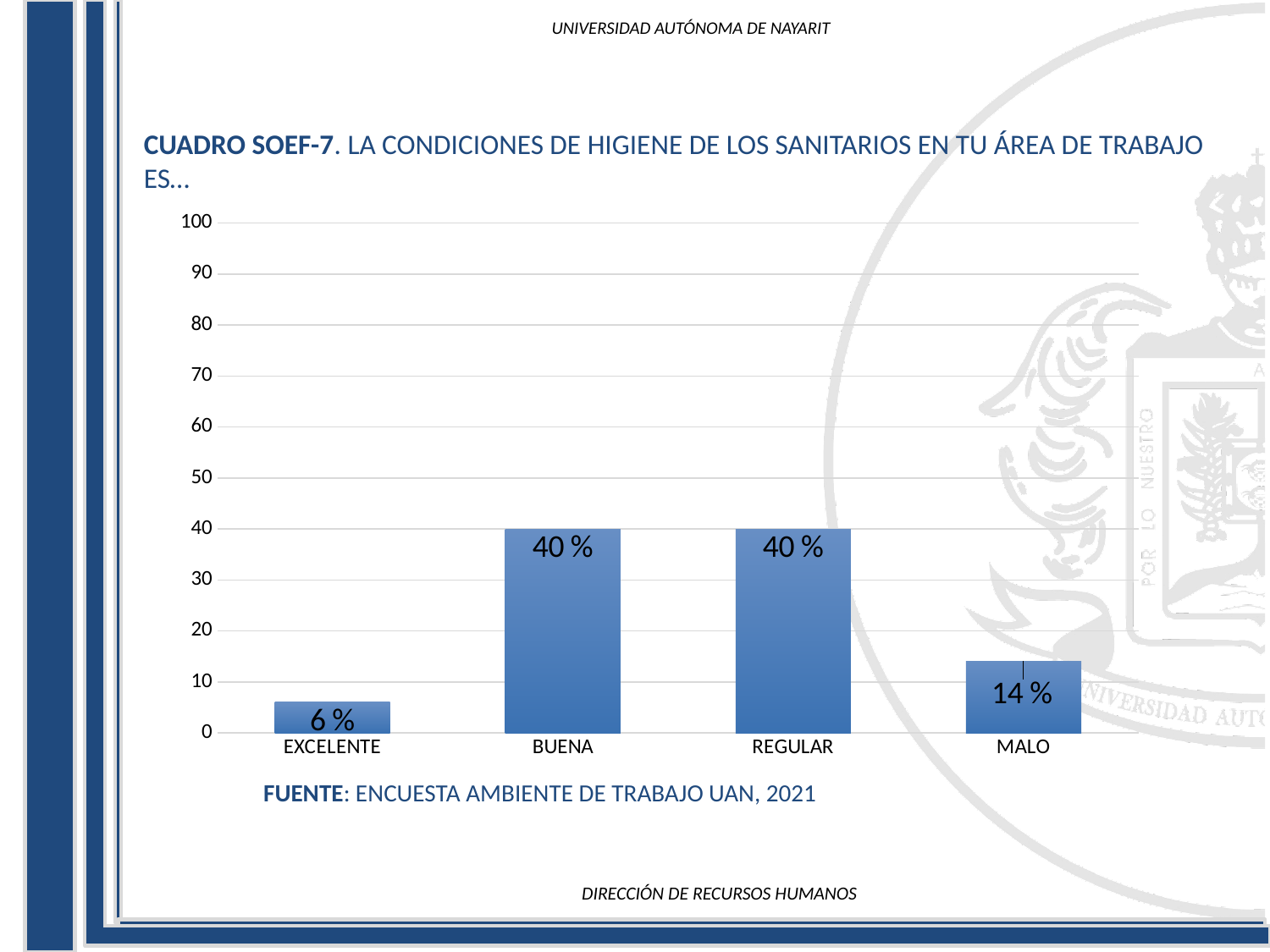
Which category has the lowest value? EXCELENTE What is the value for MALO? 14 % Is the value for REGULAR greater or less than 30? greater What is the value for EXCELENTE? 6 % What is the source cited below the chart? ENCUESTA AMBIENTE DE TRABAJO UAN, 2021 What is the difference between the values for BUENA and MALO? 26 % What is the value for BUENA? 40 % Which is larger, the value for MALO or the value for EXCELENTE? MALO What is the difference between the values for MALO and EXCELENTE? 8 % What kind of chart is shown on the slide? bar chart Is the value for MALO greater or less than 20? less How many categories are shown on the x axis? 4